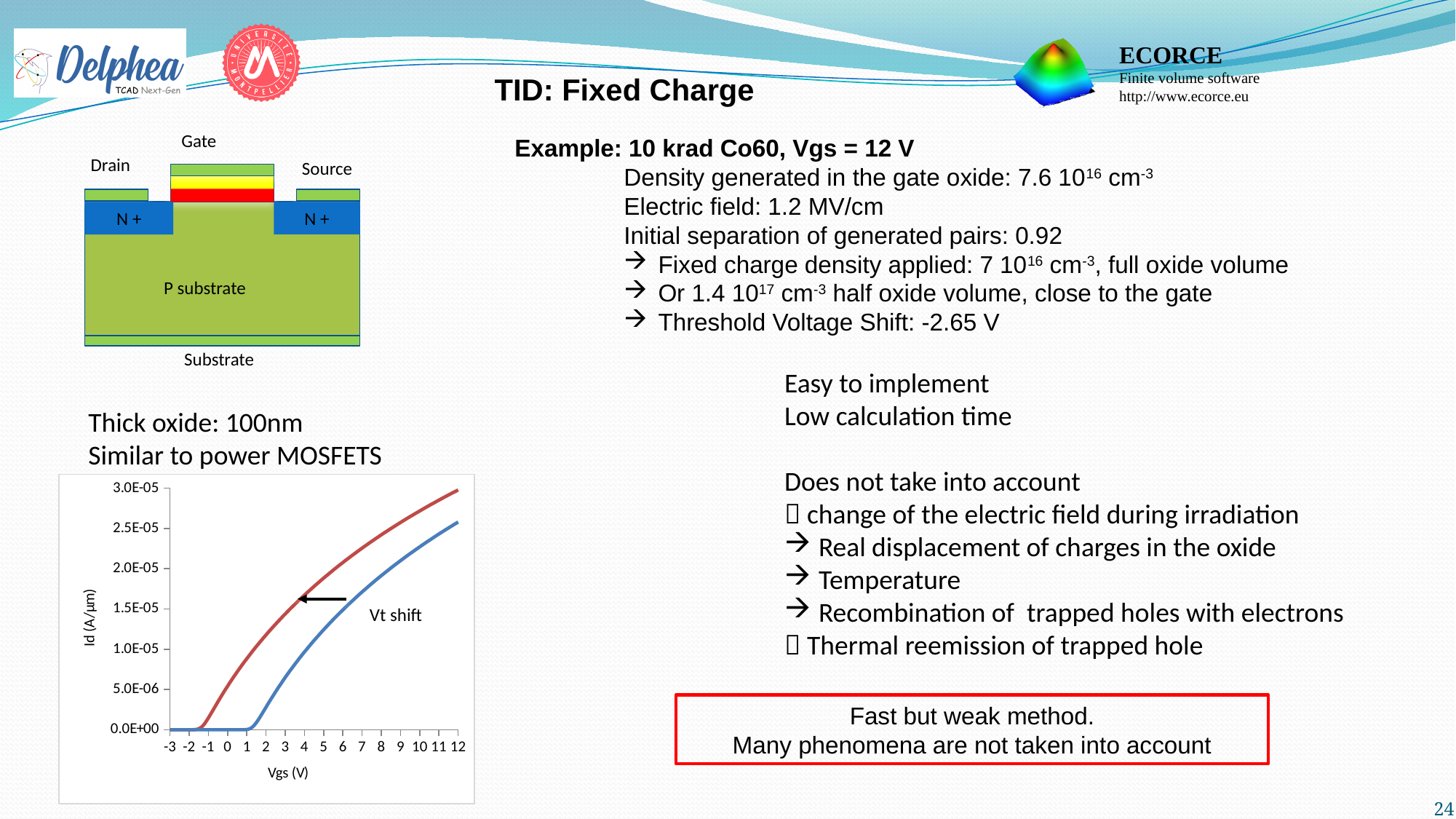
Does the drain current Id rise or fall as Vgs increases from 2 V to 12 V? rise At Vgs = 6 V, which curve has the higher Id, the red one or the blue one? the red one What is the label of the x axis of the chart? Vgs (V) What kind of chart is shown at the bottom left of the slide? line chart Which curve starts rising at a lower Vgs, the red one or the blue one? the red one How many curves are plotted on the chart? 2 Is the Id value of the blue curve at Vgs = 9 V greater or less than 1.5E-05? greater What is the highest tick value shown on the y axis of the chart? 3.0E-05 Is the Id value of the blue curve at Vgs = 3 V greater or less than 5.0E-06? greater What is the label of the y axis of the chart? Id (A/µm) Is the Id value of the red curve at Vgs = 3 V greater or less than 1.0E-05? greater